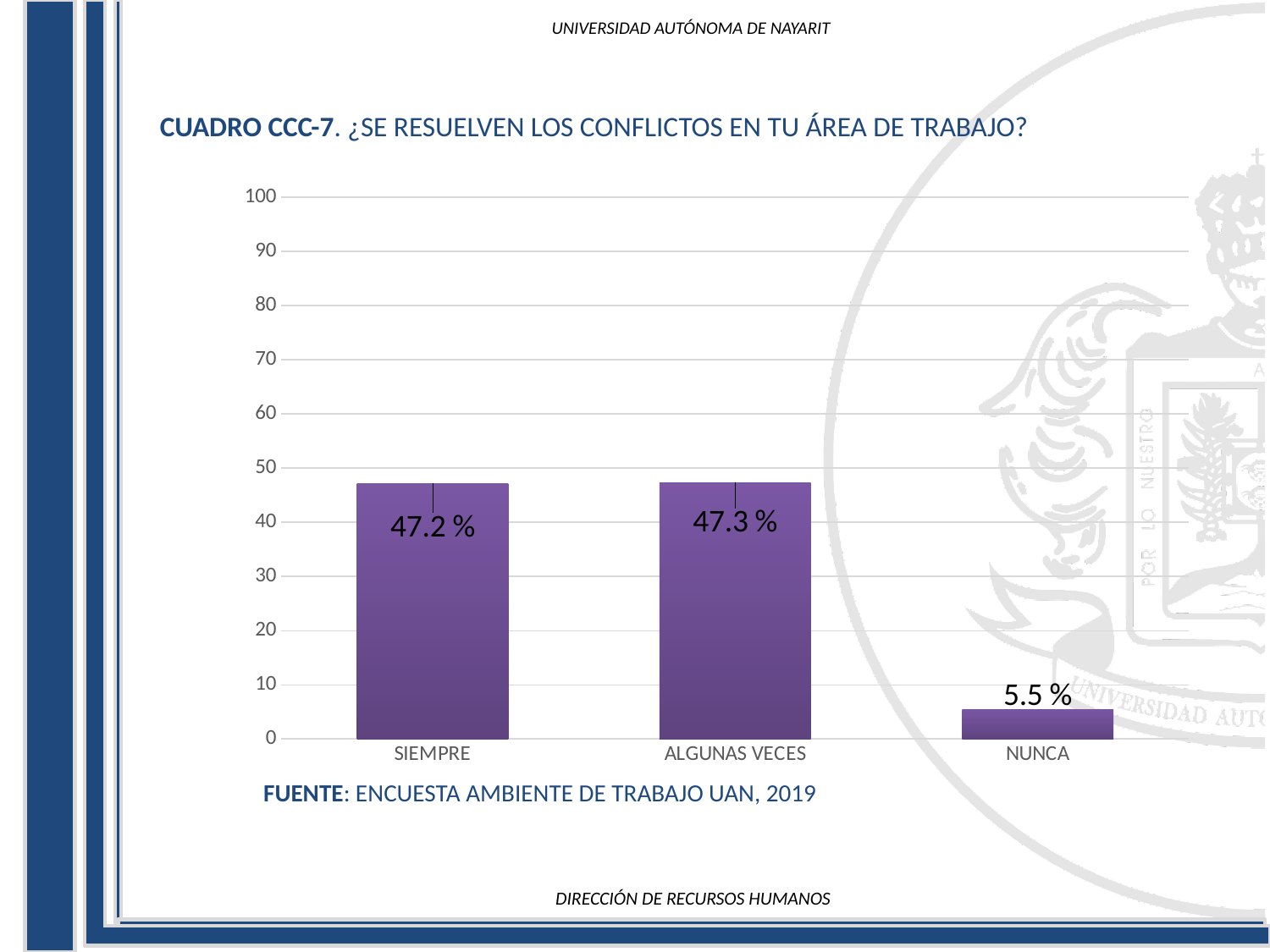
Which category has the lowest value? NUNCA What is the value for ALGUNAS VECES? 47.3 % What is the value for NUNCA? 5.5 % What source is cited below the chart? ENCUESTA AMBIENTE DE TRABAJO UAN, 2019 What kind of chart is shown on the slide? bar chart What is the difference between the values for ALGUNAS VECES and NUNCA? 41.8 % Is the value for SIEMPRE greater or less than 50? less What is the difference between the values for SIEMPRE and NUNCA? 41.7 % Which is larger, the value for SIEMPRE or the value for NUNCA? SIEMPRE What is the value for SIEMPRE? 47.2 % Is the value for NUNCA greater or less than 10? less How many categories are shown on the x axis? 3